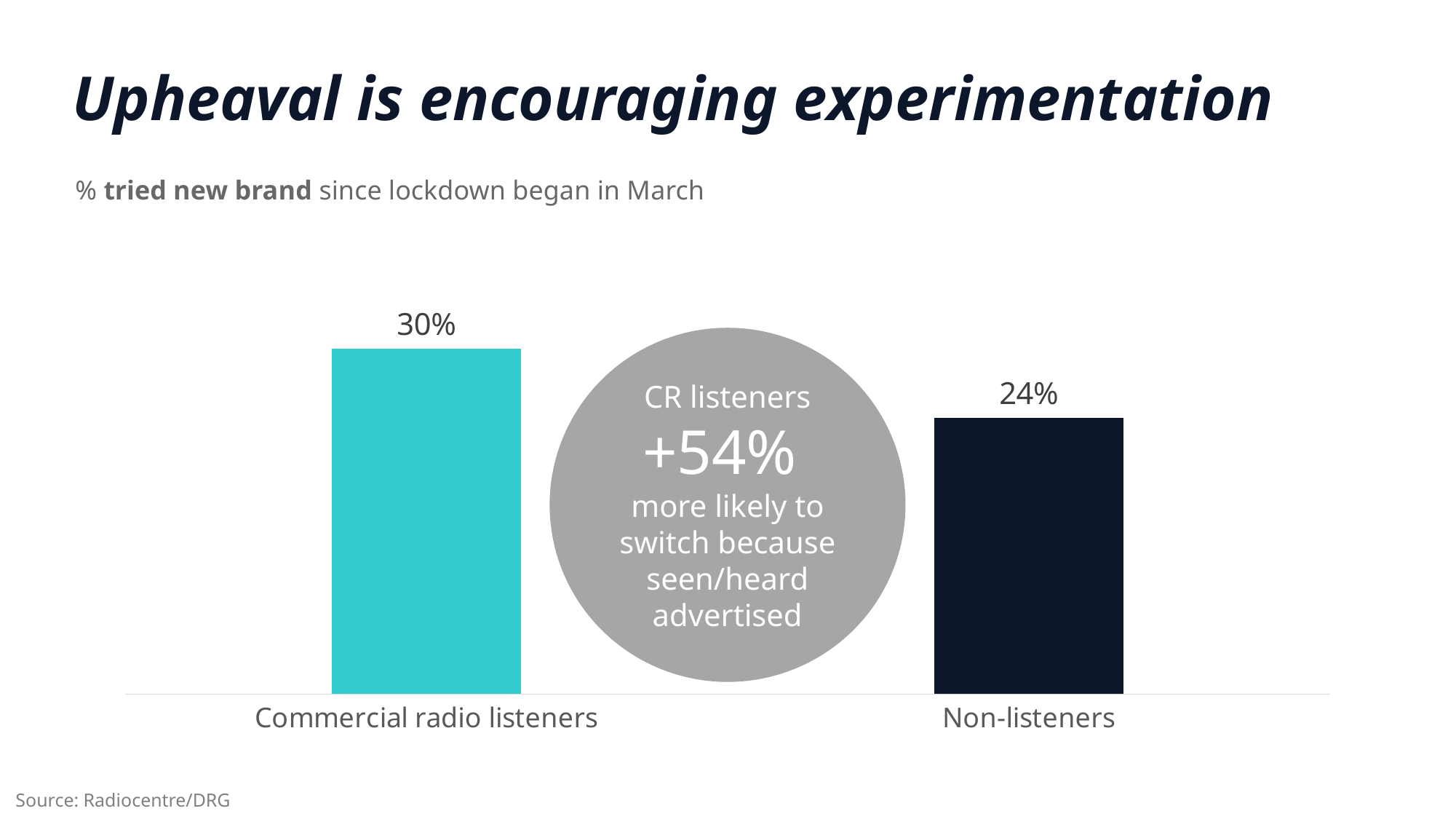
What type of chart is shown on the slide? Bar chart What percentage of commercial radio listeners tried a new brand since lockdown began in March? 30% What is the difference in percentage points between commercial radio listeners and non-listeners who tried a new brand? 6 percentage points Is the value for commercial radio listeners larger or smaller than the value for non-listeners? Larger Which group has the higher percentage who tried a new brand? Commercial radio listeners What percentage of non-listeners tried a new brand since lockdown began in March? 24% Which group has the lower percentage who tried a new brand? Non-listeners According to the grey circle, how much more likely are CR listeners to switch because they have seen/heard advertised? +54% What is the title of the slide? Upheaval is encouraging experimentation How many categories are shown in the chart? 2